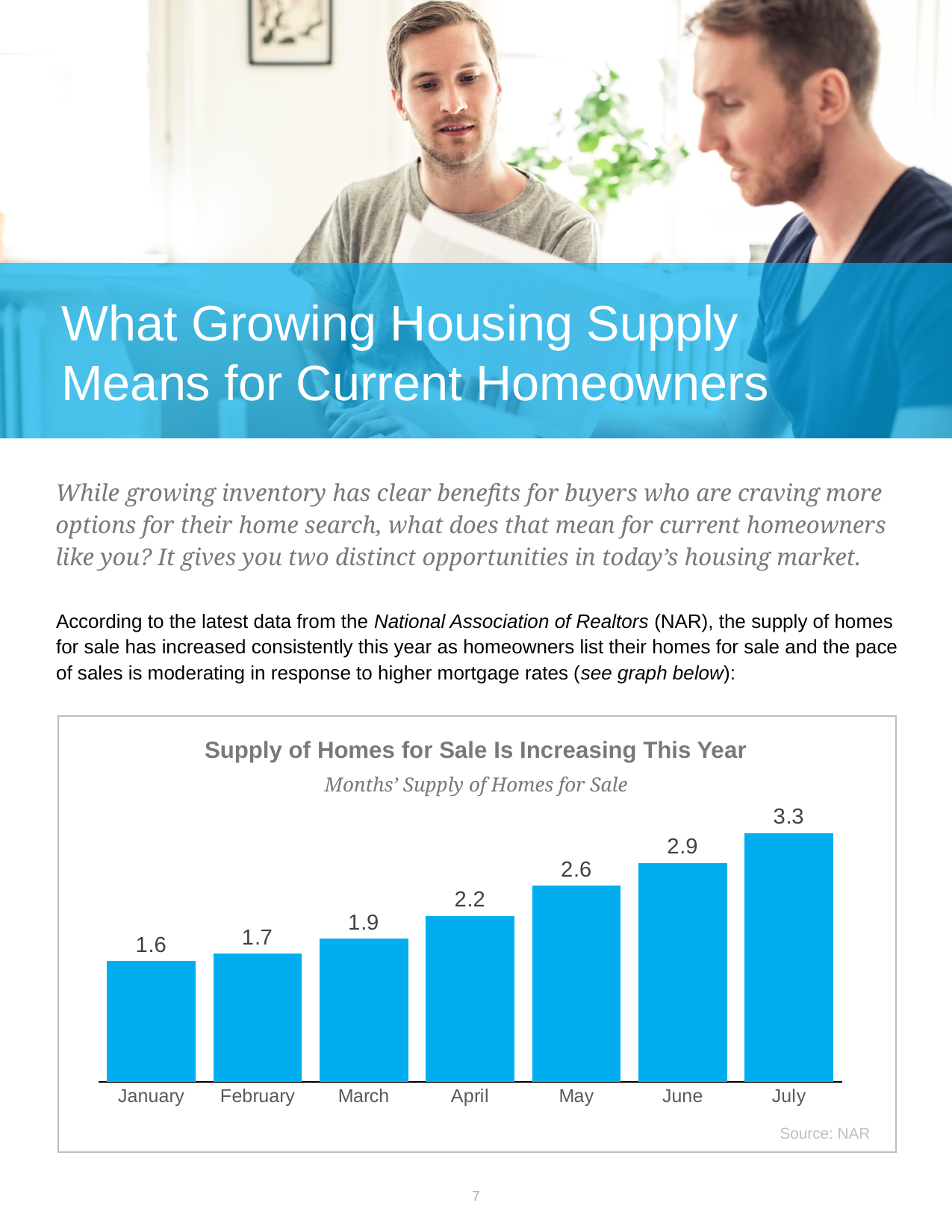
Which month has the lowest months' supply of homes for sale? January What is the title of the chart? Supply of Homes for Sale Is Increasing This Year What is the months' supply of homes for sale in January? 1.6 What kind of chart is shown on the slide? Bar chart What is the difference in months' supply between July and January? 1.7 How many months are shown on the chart? 7 What is the months' supply of homes for sale in April? 2.2 Which month has a larger months' supply, February or May? May Which month has the highest months' supply of homes for sale? July What is the difference in months' supply between May and March? 0.7 What is the months' supply of homes for sale in June? 2.9 Do the values rise or fall from January to July? Rise